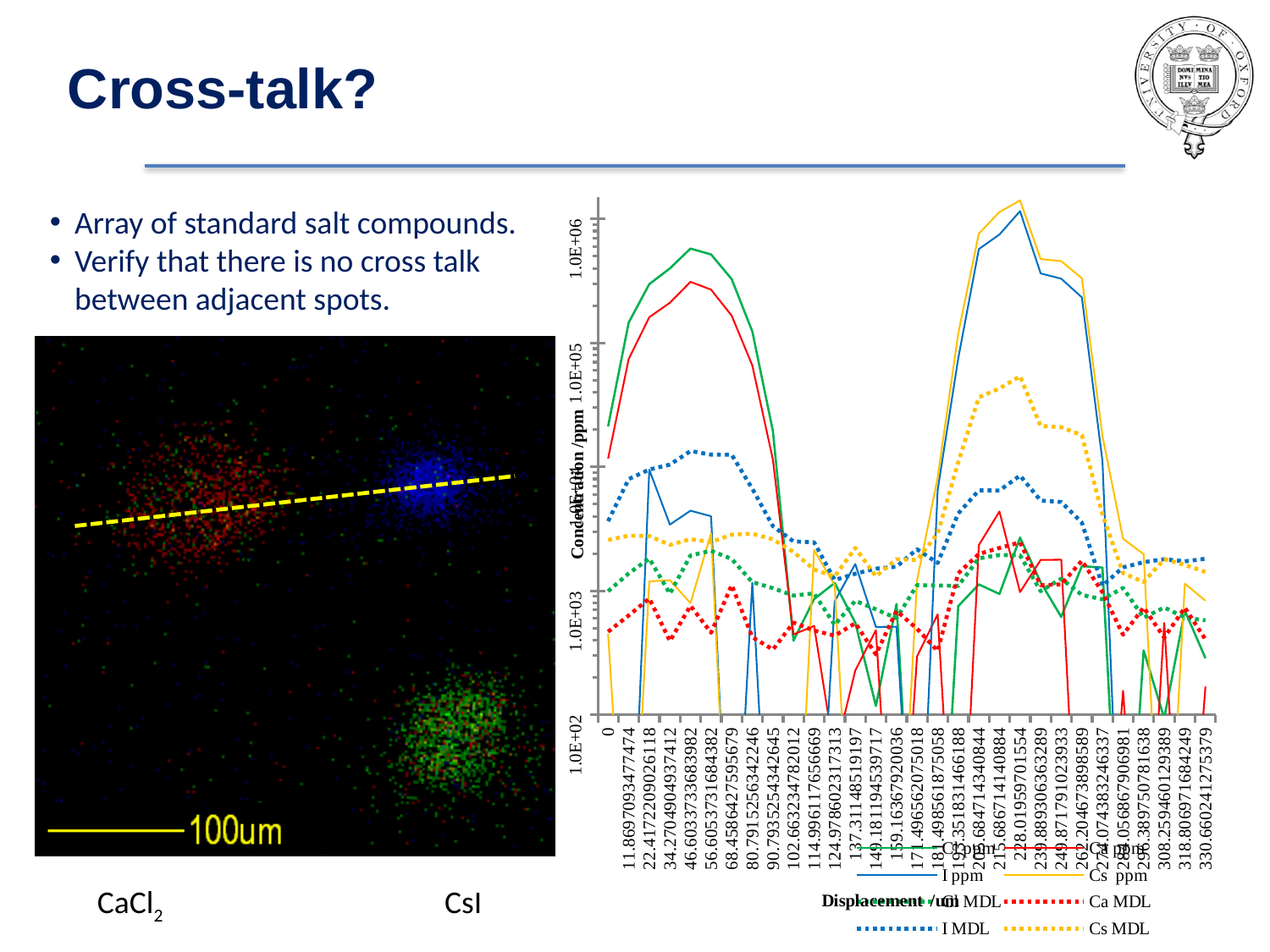
Does the Cs ppm series rise or fall between displacement 228 um and 296 um? fall What is the title of the chart's horizontal axis? Displacement /um Is the Cs MDL value at displacement 0 greater or less than 1.0E+04? less What kind of chart is shown on the slide? line chart Does the Cl ppm series rise or fall between displacement 0 and 46.6 um? rise Is the peak value of the Ca ppm series greater or less than 1.0E+06? less At the first peak (around 46.6 um), which series is higher, Cl ppm or Ca ppm? Cl ppm Is the peak value of the Cl ppm series greater or less than 1.0E+05? greater What is the title of the chart's vertical axis? Concentration /ppm How many series does the chart's legend list? 8